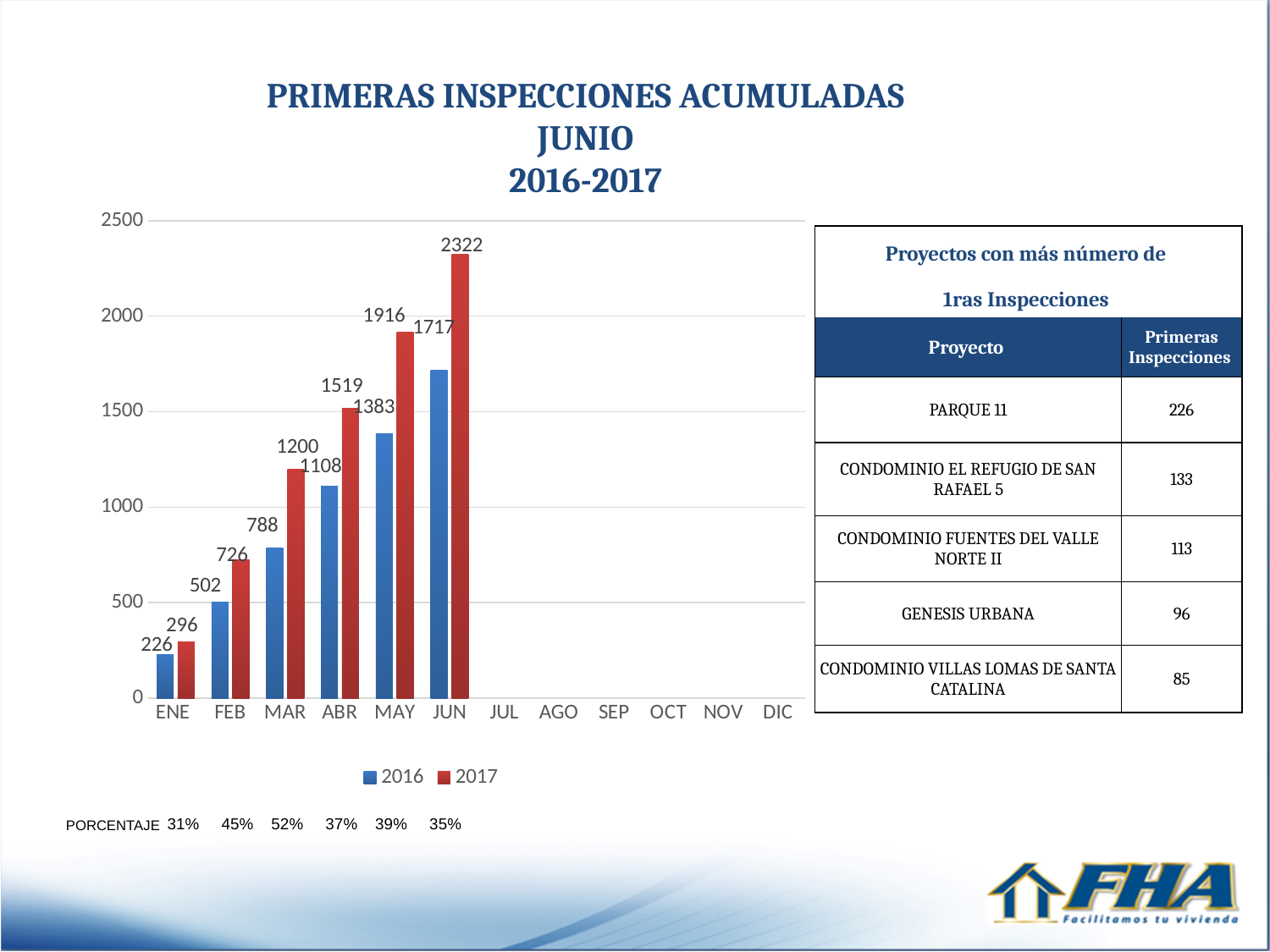
Do the 2016 values rise or fall from ENE to JUN? rise How many months on the x axis have bars plotted? 6 What is the value for 2017 in ABR? 1519 What is the value for 2016 in MAR? 788 How many series does the legend list? 2 What kind of chart is shown on the slide? bar chart What is the difference between the 2017 and 2016 values in MAY? 533 Which is larger in FEB, the 2016 value or the 2017 value? 2017 What is the value for 2016 in ENE? 226 What is the value for 2017 in JUN? 2322 Which month has the lowest value for the 2016 series? ENE Which month has the highest value for the 2017 series? JUN